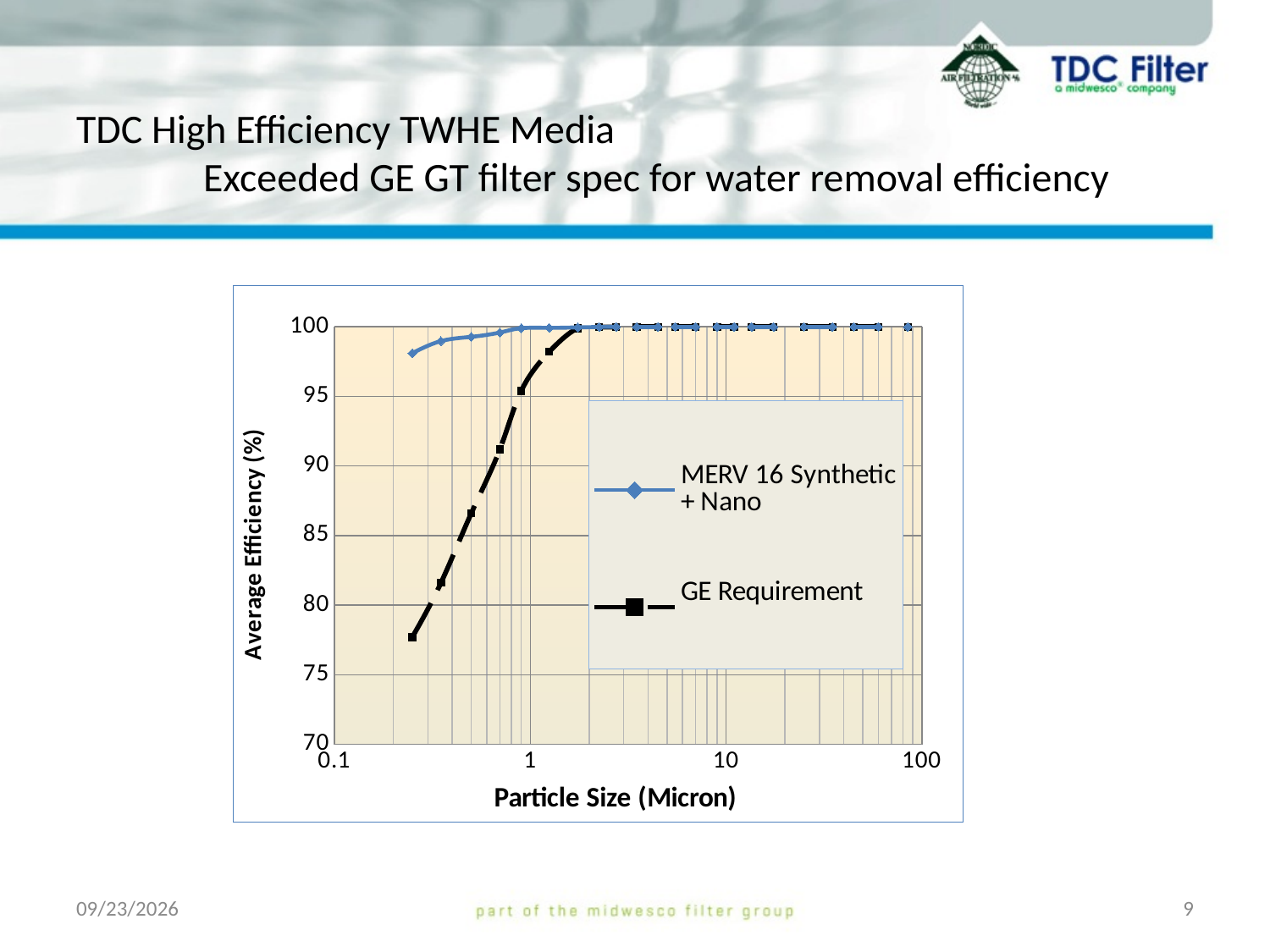
What kind of chart is shown on the slide? line chart Does the MERV 16 Synthetic + Nano line rise or fall as particle size increases? rise At a particle size of about 0.3 micron, which series has the higher average efficiency, MERV 16 Synthetic + Nano or GE Requirement? MERV 16 Synthetic + Nano What is the title of the chart's x axis? Particle Size (Micron) What are the two series named in the chart's legend? MERV 16 Synthetic + Nano; GE Requirement At a particle size of 10 micron, is the GE Requirement value greater or less than 95? greater Which series has the lower average efficiency at the smallest particle size plotted? GE Requirement At the smallest particle size plotted, is the GE Requirement value greater or less than 80? less Does the GE Requirement line rise or fall as particle size increases? rise How many series does the chart's legend list? 2 At a particle size of 0.5 micron, is the GE Requirement value greater or less than 90? less